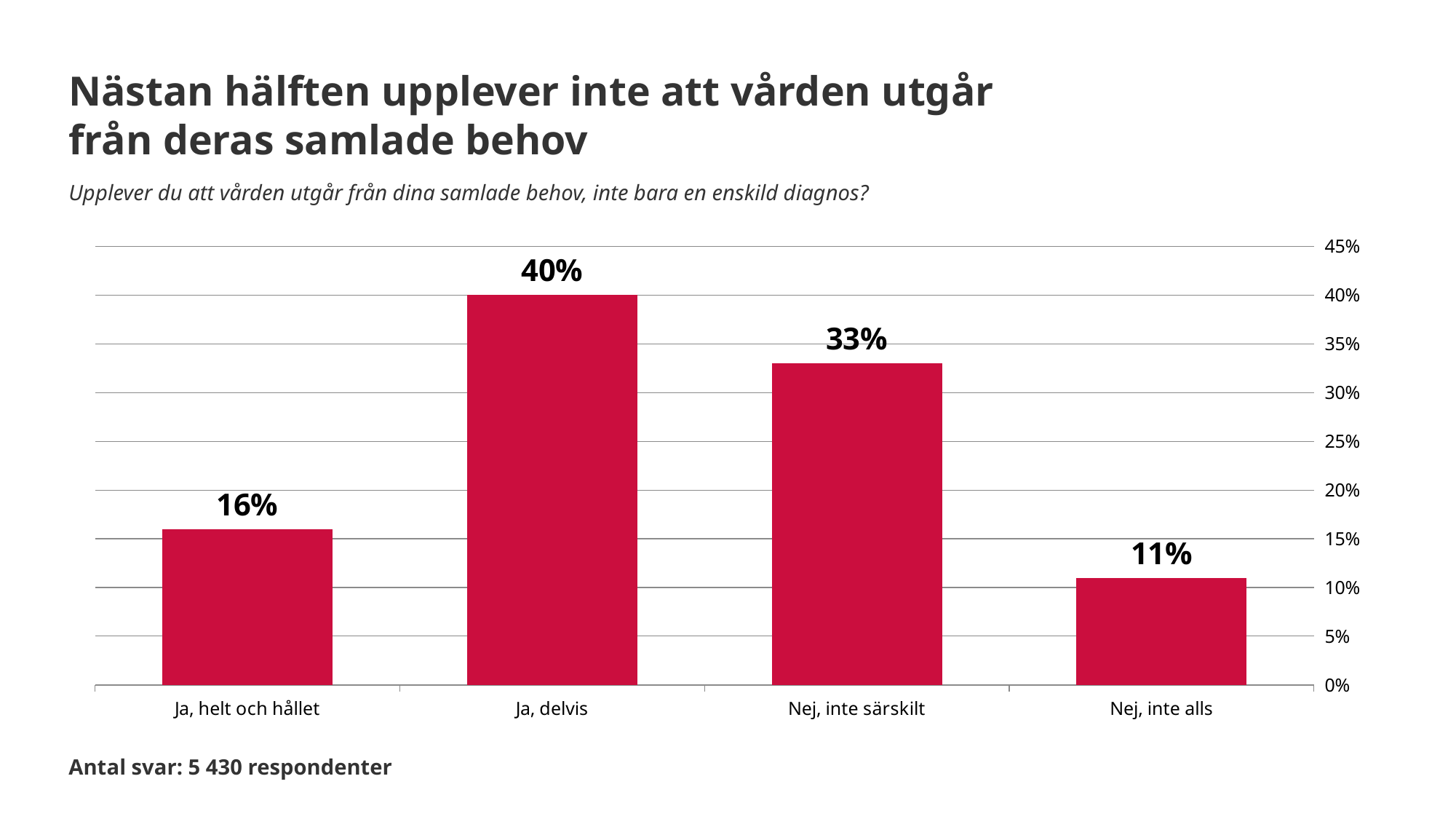
What kind of chart is shown on the slide? bar chart How many categories are shown on the x axis? 4 How many respondents does the slide say answered the question? 5 430 Which category has the highest value? Ja, delvis What is the value for "Ja, helt och hållet"? 16% What is the value for "Nej, inte alls"? 11% What is the value for "Ja, delvis"? 40% Which is larger, the value for "Ja, helt och hållet" or the value for "Nej, inte alls"? Ja, helt och hållet Is the value for "Nej, inte särskilt" greater or less than 30%? greater What is the difference between the values for "Ja, delvis" and "Nej, inte särskilt"? 7% Which category has the lowest value? Nej, inte alls What is the combined value of "Nej, inte särskilt" and "Nej, inte alls"? 44%